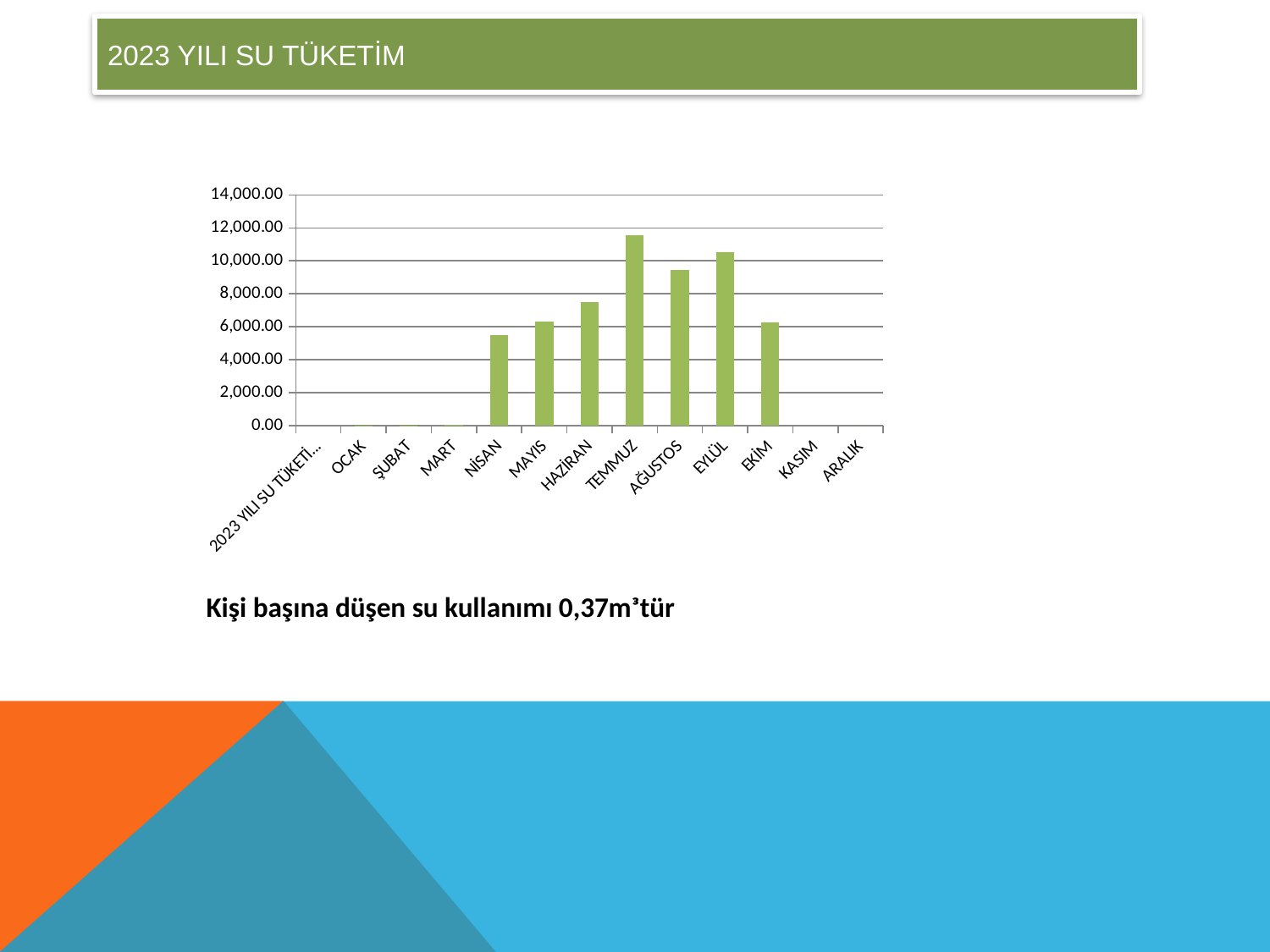
Do the values rise or fall from NİSAN to TEMMUZ? rise How many category labels are shown along the x axis of the chart? 13 What colour are the bars in the chart? Green What kind of chart is shown on the slide? Bar chart Which month has the highest bar in the chart? TEMMUZ Is the value for TEMMUZ greater or less than 10,000.00? greater Which is larger, the value for TEMMUZ or the value for AĞUSTOS? TEMMUZ Is the value for NİSAN greater or less than 6,000.00? less Is the value for AĞUSTOS greater or less than 8,000.00? greater Which is larger, the value for EYLÜL or the value for EKİM? EYLÜL